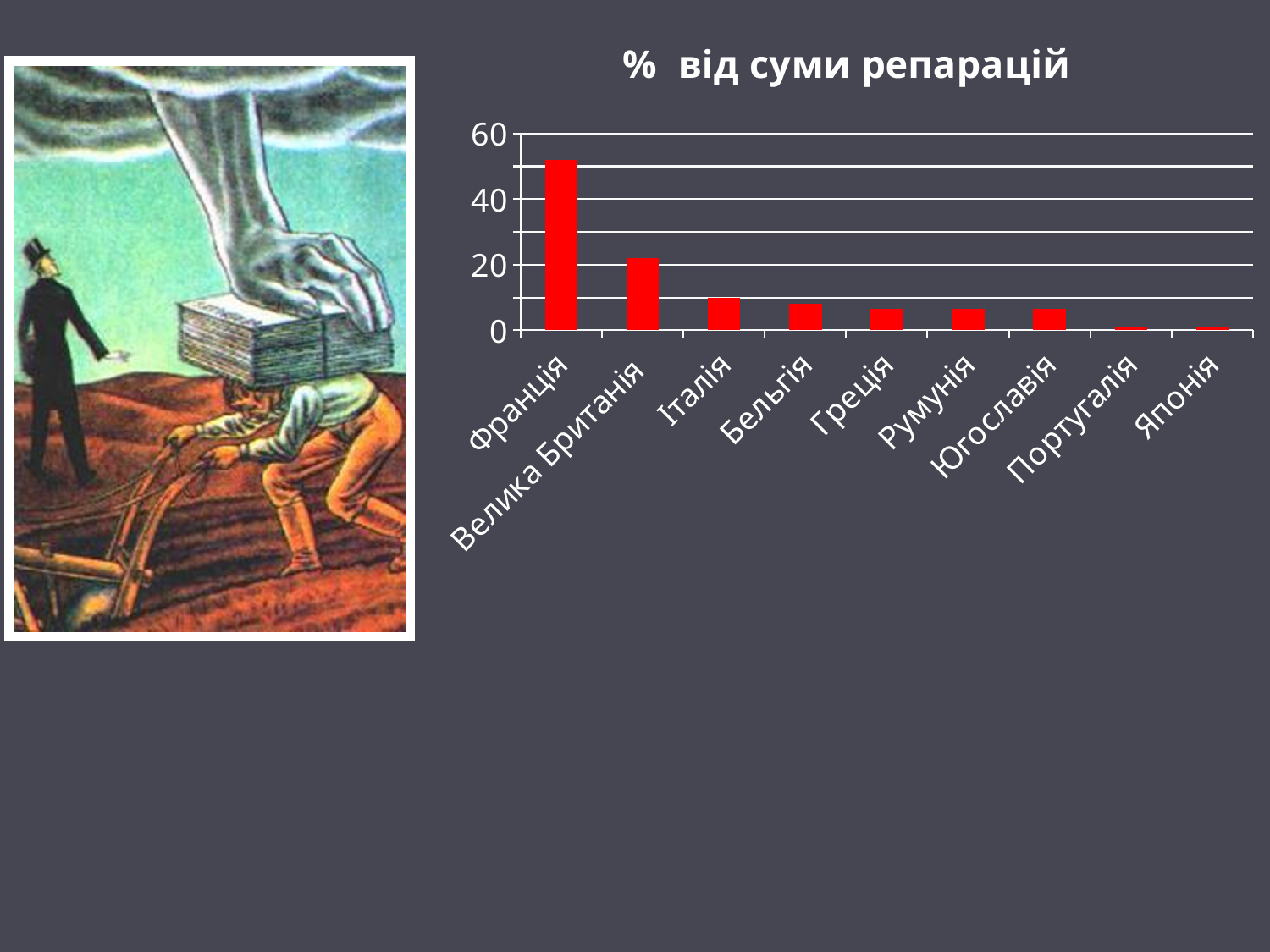
What is the title of the chart? % від суми репарацій How many countries are shown on the x axis of the chart? 9 Is the value for Велика Британія greater or less than 40? less Is the value for Велика Британія greater or less than 20? greater What kind of chart is shown on the slide? bar chart Which is larger, the value for Італія or the value for Португалія? Італія Do the values generally rise or fall moving from left to right along the x axis? fall Which country has the highest value in the chart? Франція Is the value for Італія greater or less than 20? less Which is larger, the value for Франція or the value for Велика Британія? Франція